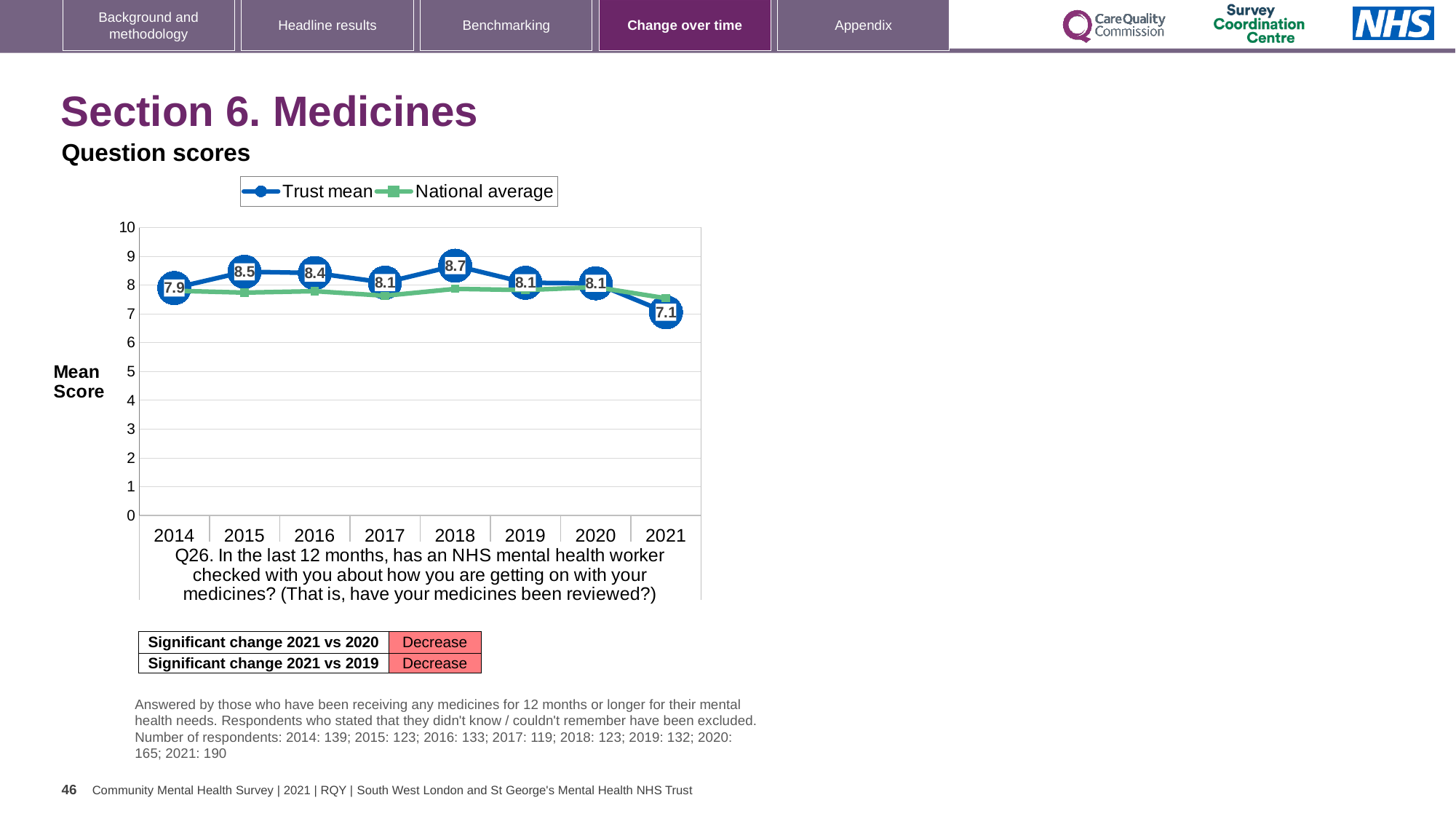
What is the Trust mean score for 2018? 8.7 What is the Trust mean score for 2014? 7.9 What kind of chart is shown on the slide? Line chart How many years are shown on the x axis of the chart? 8 How many series does the chart legend list? 2 Does the Trust mean score rise or fall from 2020 to 2021? Fall In which year is the Trust mean score lowest? 2021 Which is larger, the Trust mean score in 2015 or in 2016? 2015 In which year is the Trust mean score highest? 2018 Is the National average for 2021 greater or less than 7? greater What is the difference between the Trust mean score in 2020 and in 2021? 1.0 What is the Trust mean score for 2021? 7.1